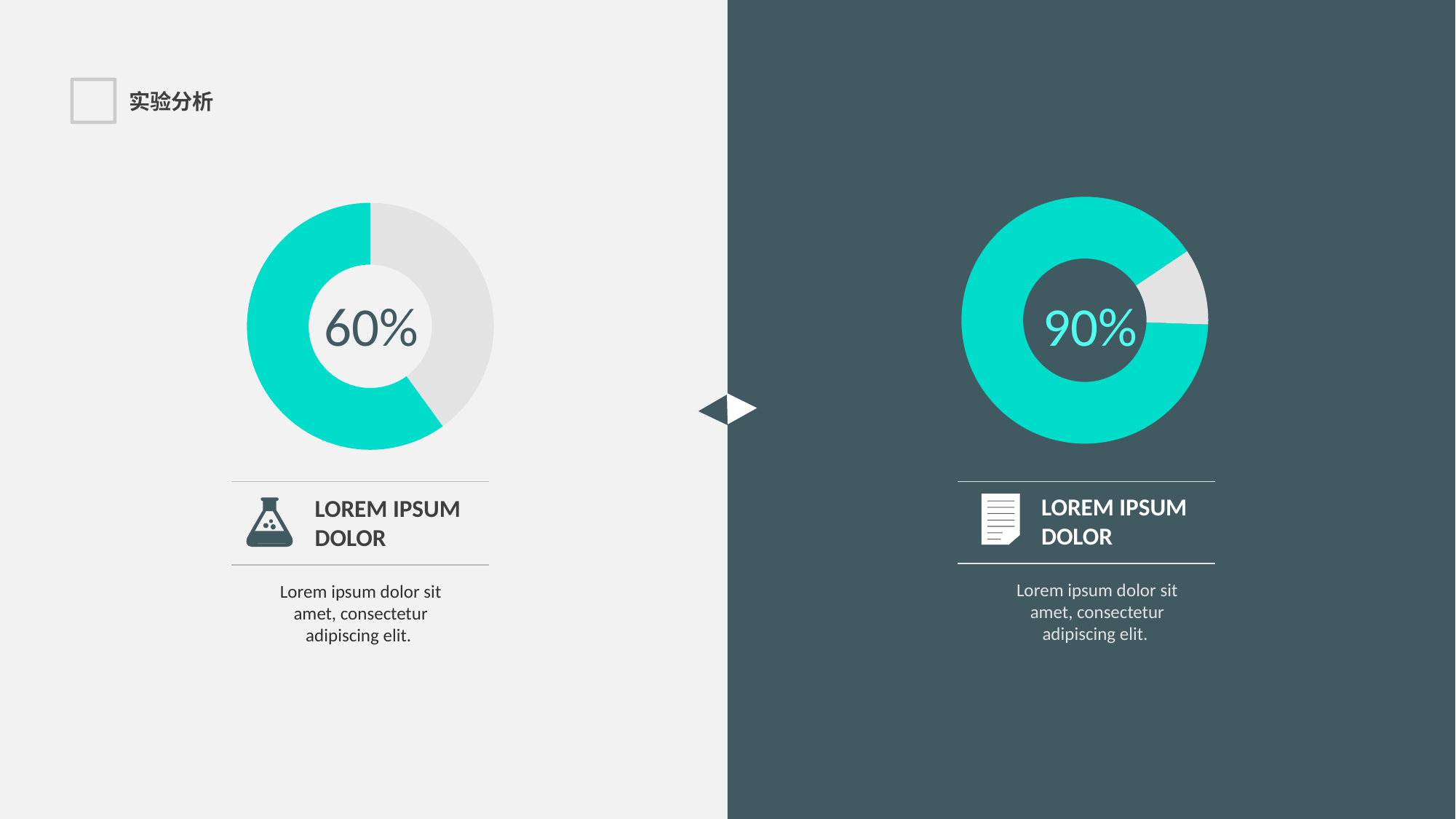
What percentage is shown in the centre of the donut chart on the right side of the slide? 90% What is the label printed beneath the left donut chart? LOREM IPSUM DOLOR What percentage is shown in the centre of the donut chart on the left side of the slide? 60% How many donut charts are on the slide? 2 In the left donut chart, what share of the ring is not filled with the teal colour? 40% What colour is used for the filled portion of both donut charts? Teal Is the value shown in the left donut chart greater or less than 50%? greater What kind of chart is shown on the right side of the slide? Donut chart What is the difference between the percentage in the right donut chart and the percentage in the left donut chart? 30% Which donut chart shows the larger percentage, the one on the left or the one on the right? The one on the right What kind of chart is shown on the left side of the slide? Donut chart In the right donut chart, what share of the ring is not filled with the teal colour? 10%